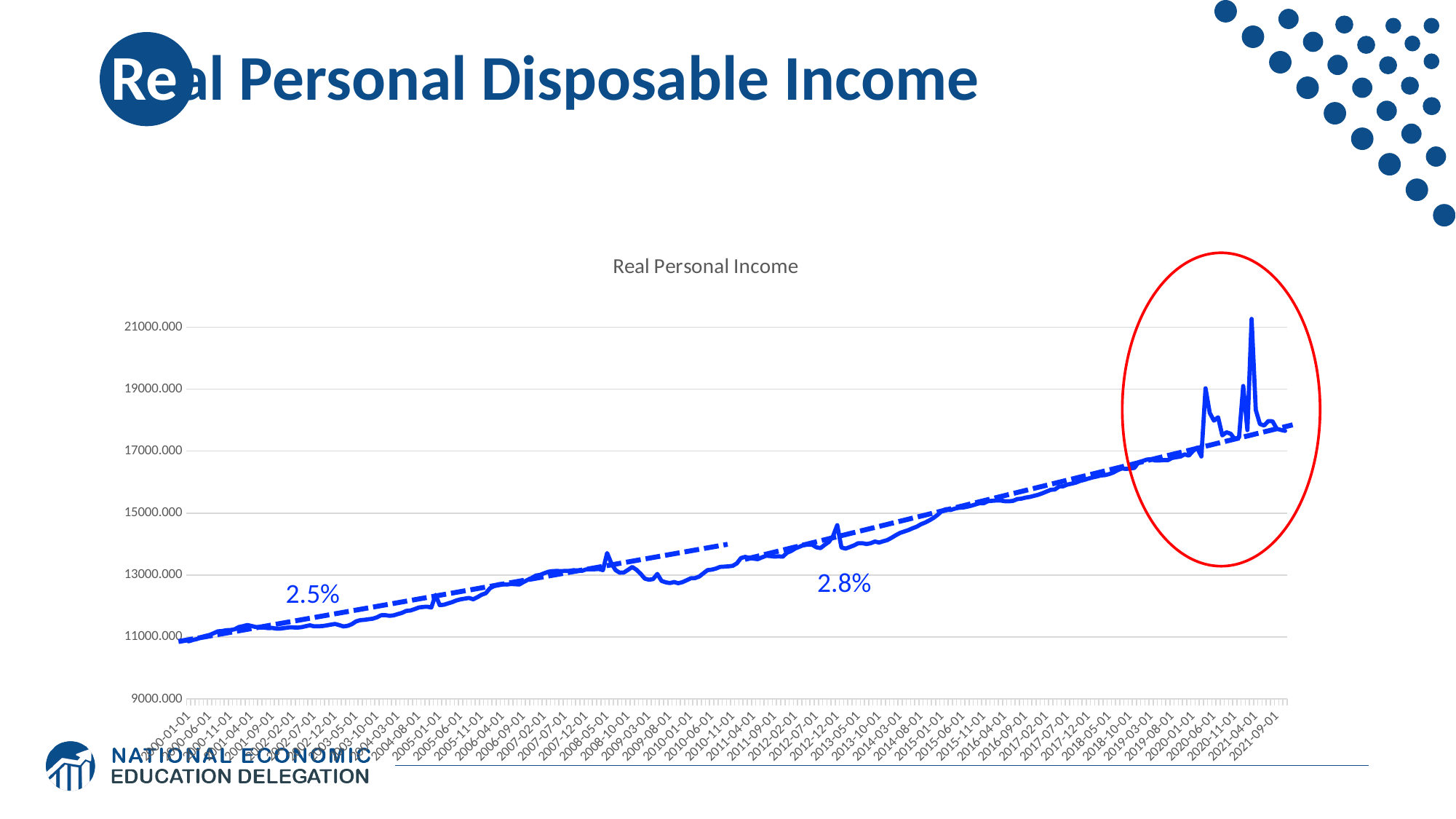
What kind of chart is shown on the slide? line chart Is the value for 2018-05-01 greater or less than 15000? greater What growth rate is annotated on the left dashed trend line? 2.5% Is the value for 2005-01-01 greater or less than 13000? less What is the title of the chart? Real Personal Income Which is larger, the value for 2015-01-01 or the value for 2005-01-01? 2015-01-01 Is the value for 2000-01-01 greater or less than 13000? less Do the values generally rise or fall from 2000 to 2021 along the x axis? rise Which is larger, the value for 2008-05-01 or the value for 2019-03-01? 2019-03-01 In which year does the highest value on the chart occur? 2021